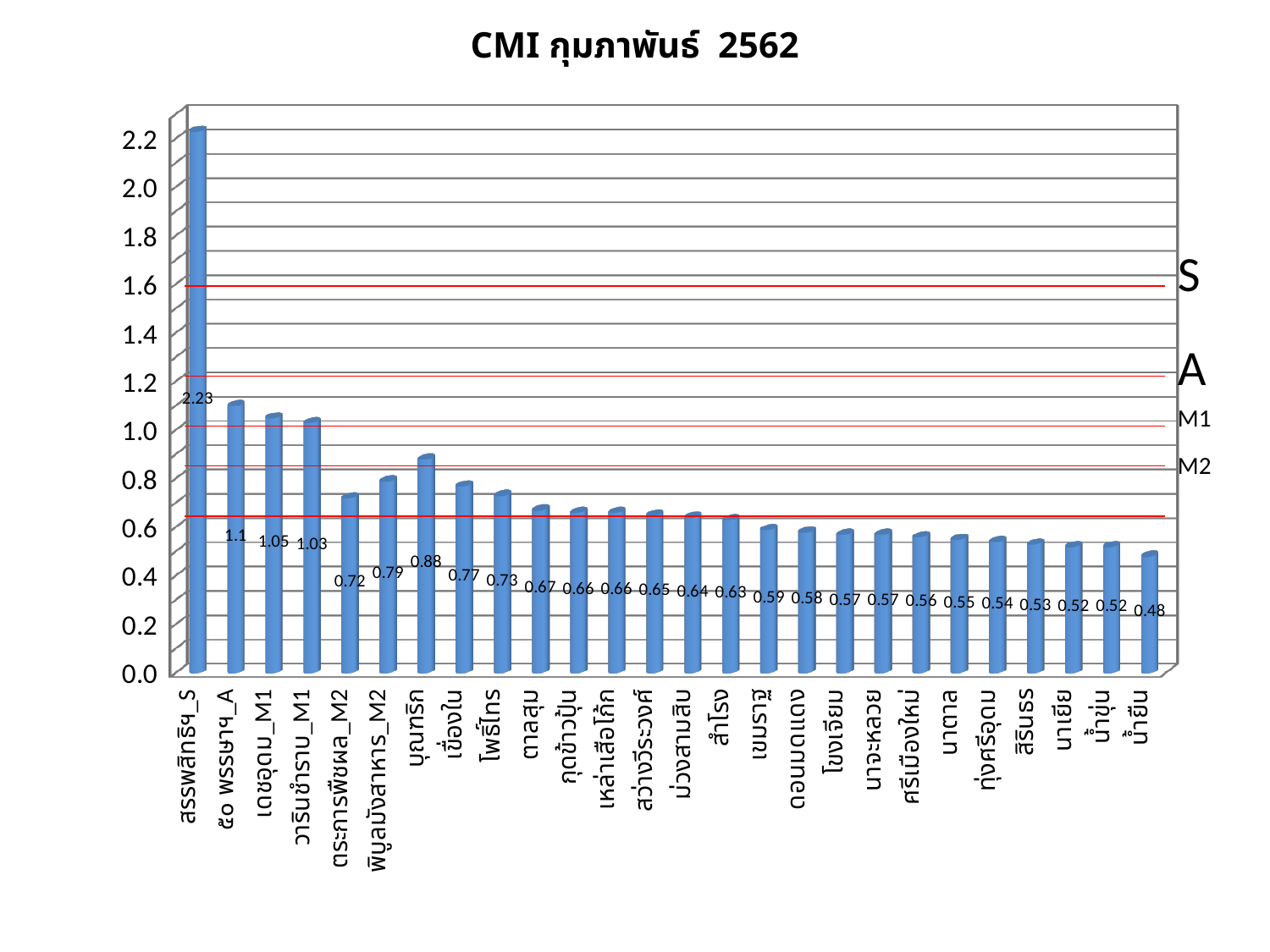
What is the difference between the values for พิบูลมังสาหาร_M2 and ตระการพืชผล_M2? 0.07 What is the value for เขมราฐ? 0.59 What is the value for สรรพสิทธิฯ_S? 2.23 What kind of chart is shown on the slide? Bar chart What is the difference between the values for สรรพสิทธิฯ_S and ๕๐ พรรษาฯ_A? 1.13 How many categories are shown on the x axis? 26 Which category has the lowest value? น้ำยืน Which category has the highest value? สรรพสิทธิฯ_S What is the value for บุณฑริก? 0.88 Is the value for สรรพสิทธิฯ_S greater or less than 2.0? greater What is the title of the chart? CMI กุมภาพันธ์ 2562 Which is larger, the value for เดชอุดม_M1 or the value for วารินชำราบ_M1? เดชอุดม_M1